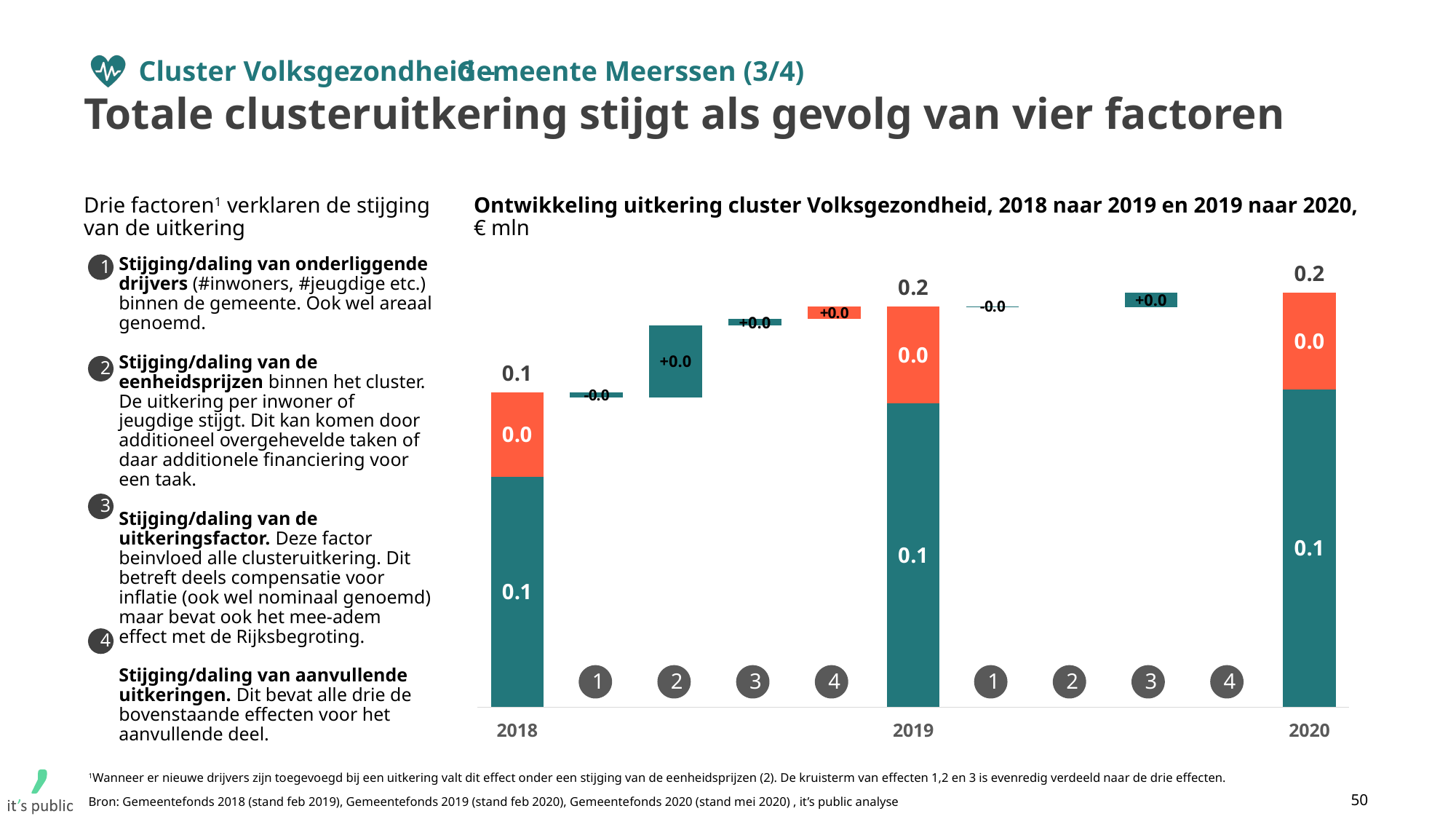
What is the total value shown above the 2020 bar? 0.2 What unit is stated under the chart title? € mln What value is printed on the teal (lower) segment of the 2020 bar? 0.1 Do the year totals rise or fall from 2018 to 2020? Rise What value is printed on the orange (upper) segment of the 2019 bar? 0.0 What kind of chart is this? Bar chart (waterfall) Which year has the lowest total value? 2018 Which is larger, the total for 2018 or the total for 2019? 2019 What is the total value shown above the 2019 bar? 0.2 What is the total value shown above the 2018 bar? 0.1 How many year totals (2018, 2019, 2020) are shown on the chart? 3 What is the difference between the total for 2019 and the total for 2018? 0.1